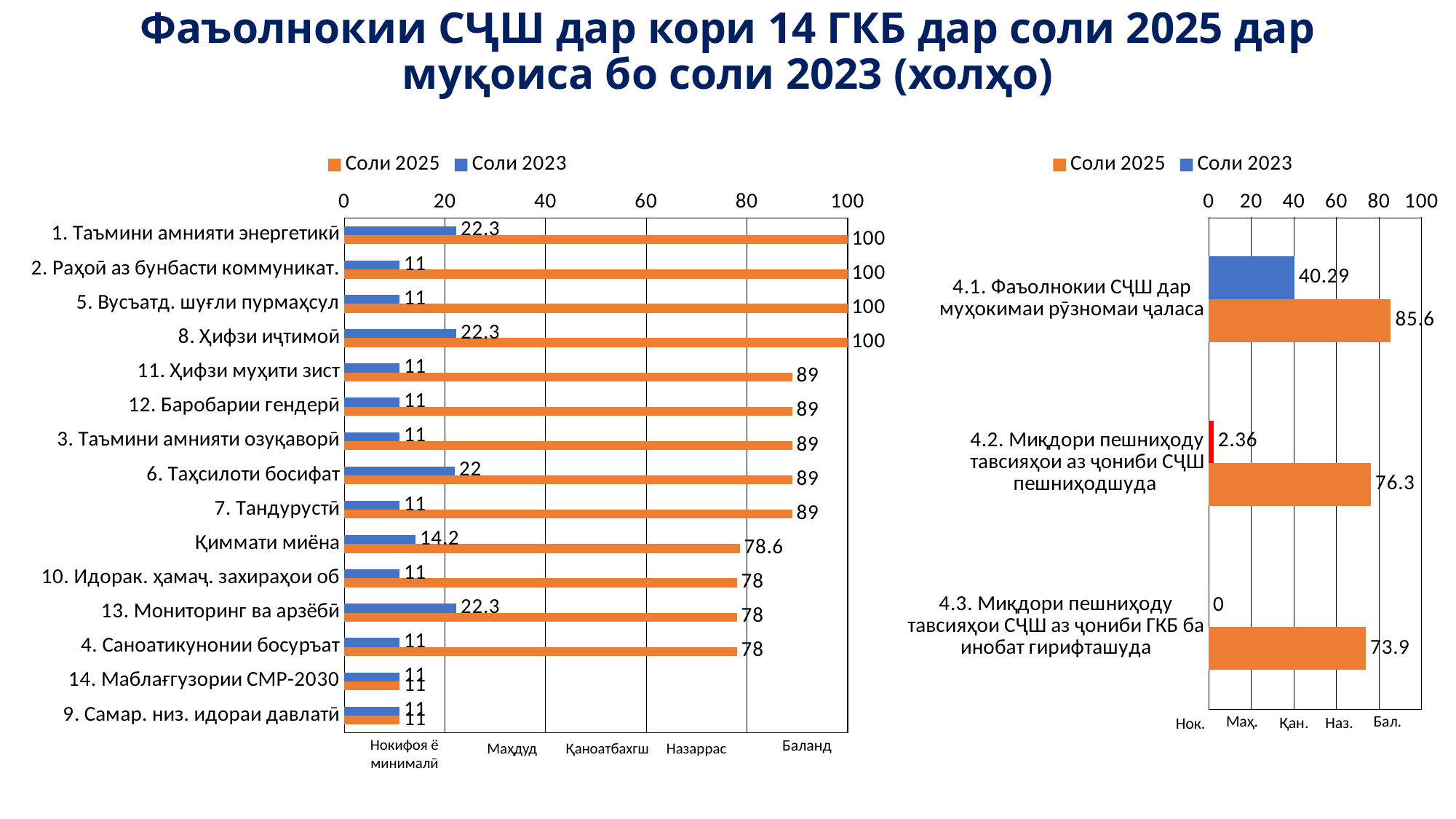
On the right chart, what colour are the Соли 2025 bars? orange What kind of chart is the right chart? bar chart On the right chart, which category has the lowest Соли 2025 value? 4.3. Миқдори пешниҳоду тавсияҳои СҶШ аз ҷониби ГКБ ба инобат гирифташуда On the left chart, which has the larger Соли 2025 value: 13. Мониторинг ва арзёбӣ or 12. Баробарии гендерӣ? 12. Баробарии гендерӣ On the left chart, what is the Соли 2025 value for Қиммати миёна? 78.6 On the left chart, what is the Соли 2023 value for 1. Таъмини амнияти энергетикӣ? 22.3 On the right chart, what is the difference between the Соли 2025 and Соли 2023 values for 4.2. Миқдори пешниҳоду тавсияҳои аз ҷониби СҶШ пешниҳодшуда? 73.94 On the left chart, what is the difference between the Соли 2025 and Соли 2023 values for 6. Таҳсилоти босифат? 67 On the left chart, what is the Соли 2025 value for 7. Тандурустӣ? 89 How many categories are plotted on the left chart? 15 On the right chart, what is the Соли 2023 value for 4.1. Фаъолнокии СҶШ дар муҳокимаи рӯзномаи ҷаласа? 40.29 How many series does the legend of the left chart list? 2